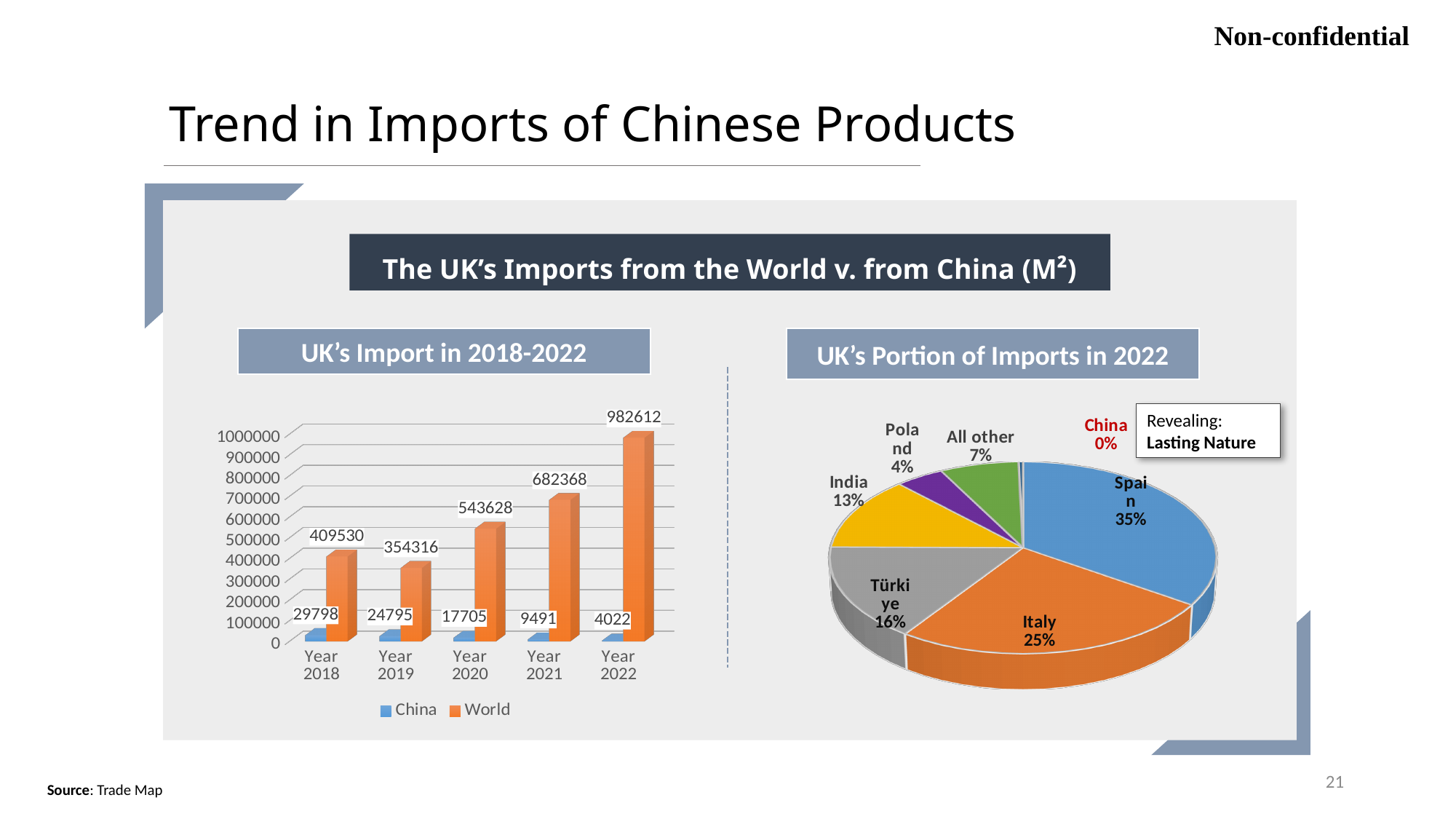
In the 'UK's Import in 2018-2022' chart, what is the value for World in Year 2022? 982612 In the 'UK's Import in 2018-2022' chart, which year has the lowest World value? Year 2019 In the 'UK's Import in 2018-2022' chart, what is the value for China in Year 2021? 9491 In the 'UK's Portion of Imports in 2022' pie chart, what share does Italy have? 25% In the 'UK's Portion of Imports in 2022' pie chart, which is larger, the share for India or the share for Türkiye? Türkiye In the 'UK's Import in 2018-2022' chart, how many series does the legend list? 2 In the 'UK's Import in 2018-2022' chart, what is the difference between the World values for Year 2022 and Year 2021? 300244 What kind of chart is 'UK's Import in 2018-2022'? bar chart In the 'UK's Import in 2018-2022' chart, what is the value for China in Year 2018? 29798 In the 'UK's Import in 2018-2022' chart, how many years are shown on the x axis? 5 In the 'UK's Portion of Imports in 2022' pie chart, which country has the largest share? Spain In the 'UK's Import in 2018-2022' chart, do the China values rise or fall from Year 2018 to Year 2022? fall